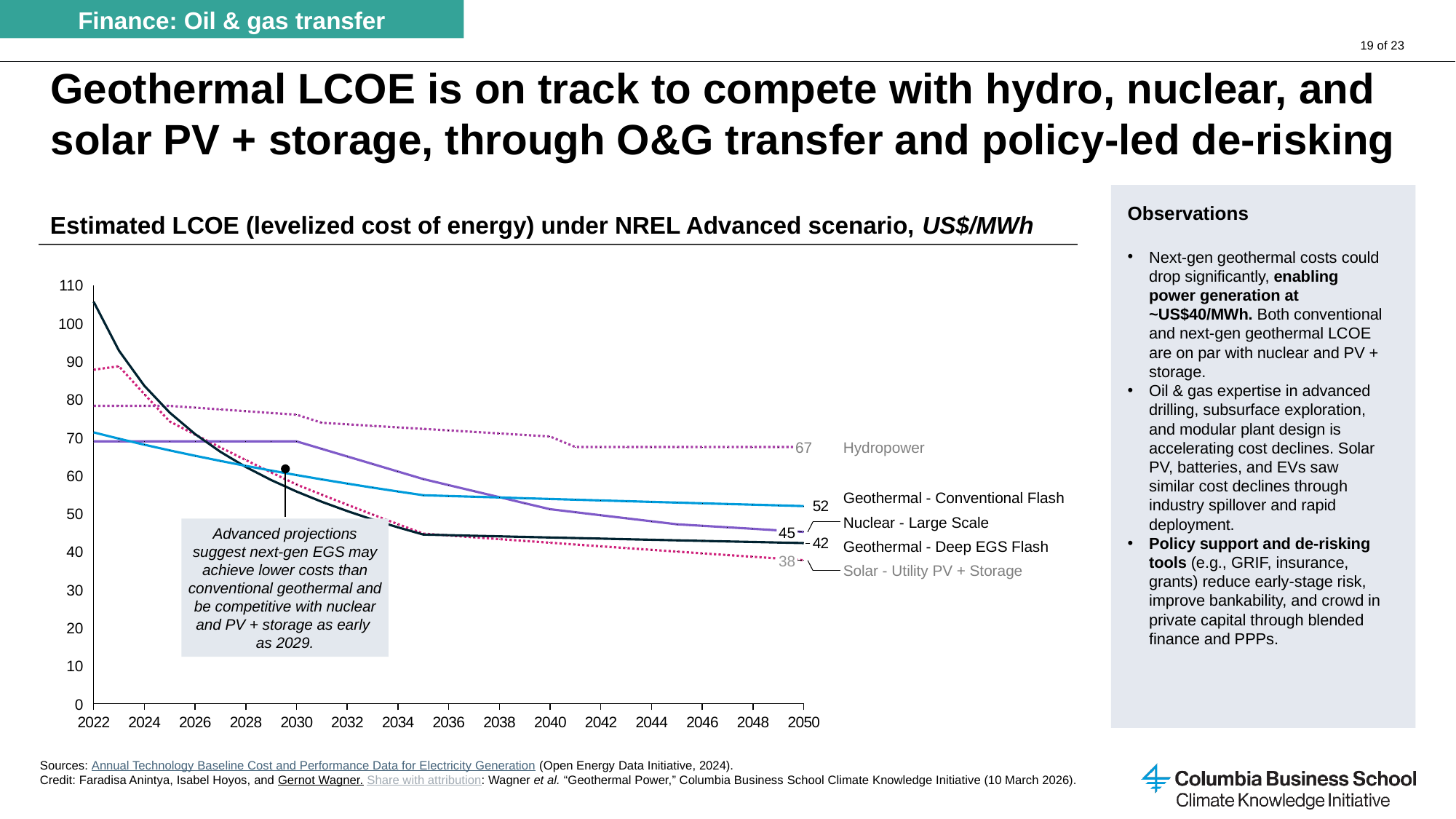
What is the 2050 LCOE value shown for Geothermal - Deep EGS Flash? 42 How many series are plotted on the chart? 5 What kind of chart is shown on the slide? line chart Is the 2022 value for Geothermal - Deep EGS Flash greater or less than 100? greater Which series has the highest LCOE value in 2050? Hydropower Which series has the lowest LCOE value in 2050? Solar - Utility PV + Storage Which is larger in 2050, the value for Nuclear - Large Scale or the value for Geothermal - Deep EGS Flash? Nuclear - Large Scale What is the difference between the 2050 values for Hydropower and Solar - Utility PV + Storage? 29 Does the Geothermal - Deep EGS Flash line rise or fall from 2022 to 2050? fall What is the 2050 LCOE value shown for Hydropower? 67 What is the 2050 LCOE value shown for Geothermal - Conventional Flash? 52 What is the 2050 LCOE value shown for Solar - Utility PV + Storage? 38